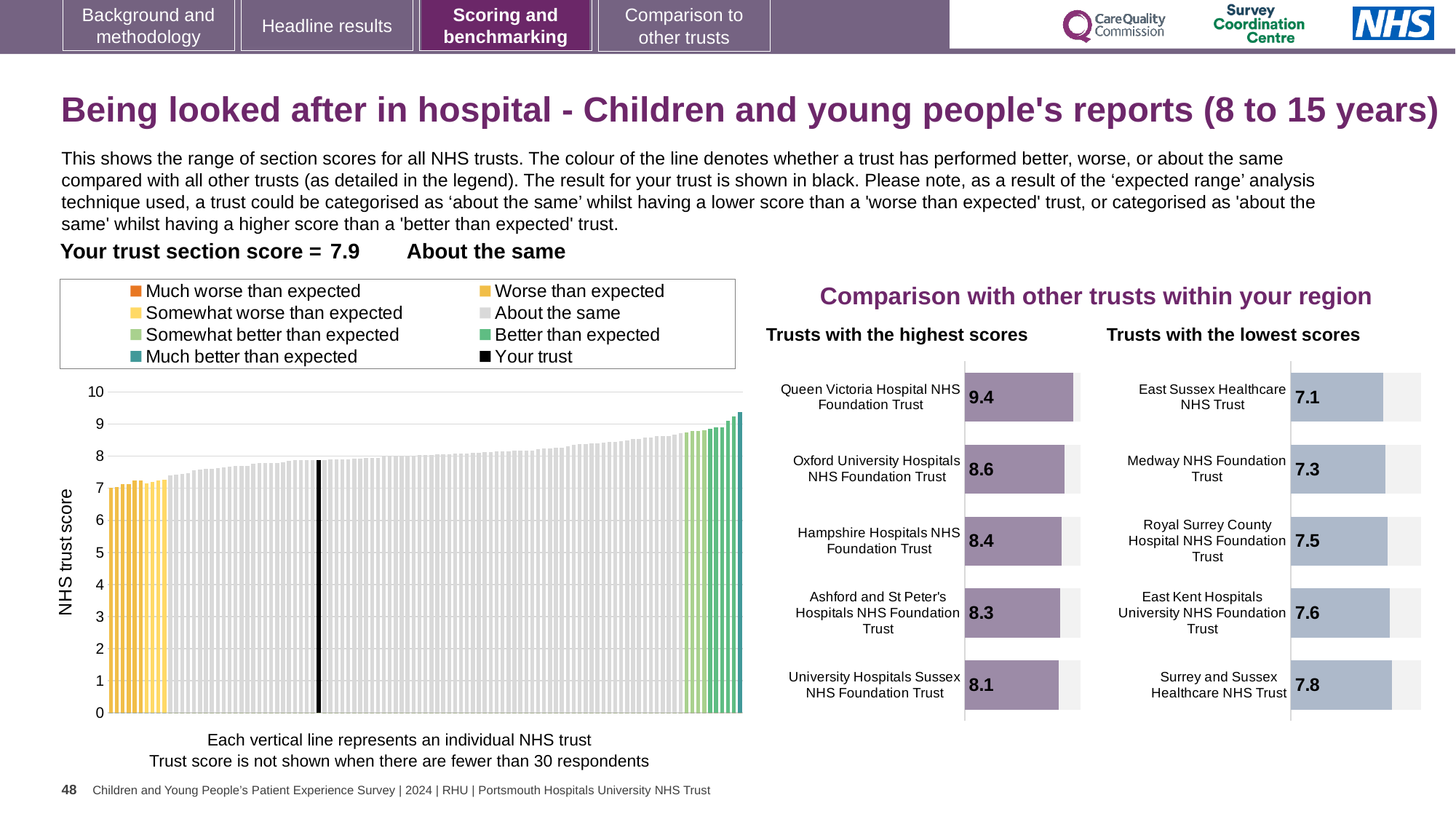
In the 'Trusts with the lowest scores' chart, which trust has the lowest score? East Sussex Healthcare NHS Trust What kind of chart is the main chart on the left showing all NHS trusts? Bar chart In the 'Trusts with the highest scores' chart, what is the score for Queen Victoria Hospital NHS Foundation Trust? 9.4 In the main chart on the left showing all NHS trusts, how many entries does the legend list? 8 In the 'Trusts with the lowest scores' chart, what is the score for Medway NHS Foundation Trust? 7.3 In the 'Trusts with the highest scores' chart, what is the difference between the scores of Queen Victoria Hospital NHS Foundation Trust and University Hospitals Sussex NHS Foundation Trust? 1.3 In the 'Trusts with the lowest scores' chart, what is the difference between the scores of Surrey and Sussex Healthcare NHS Trust and East Sussex Healthcare NHS Trust? 0.7 In the 'Trusts with the highest scores' chart, how many trusts are shown? 5 In the main chart on the left showing all NHS trusts, do the bar values rise or fall from left to right? Rise In the 'Trusts with the lowest scores' chart, which has the larger score: Medway NHS Foundation Trust or Royal Surrey County Hospital NHS Foundation Trust? Royal Surrey County Hospital NHS Foundation Trust In the main chart on the left showing all NHS trusts, is the value of the black bar (your trust) greater or less than 5? greater In the 'Trusts with the highest scores' chart, which trust has the highest score? Queen Victoria Hospital NHS Foundation Trust